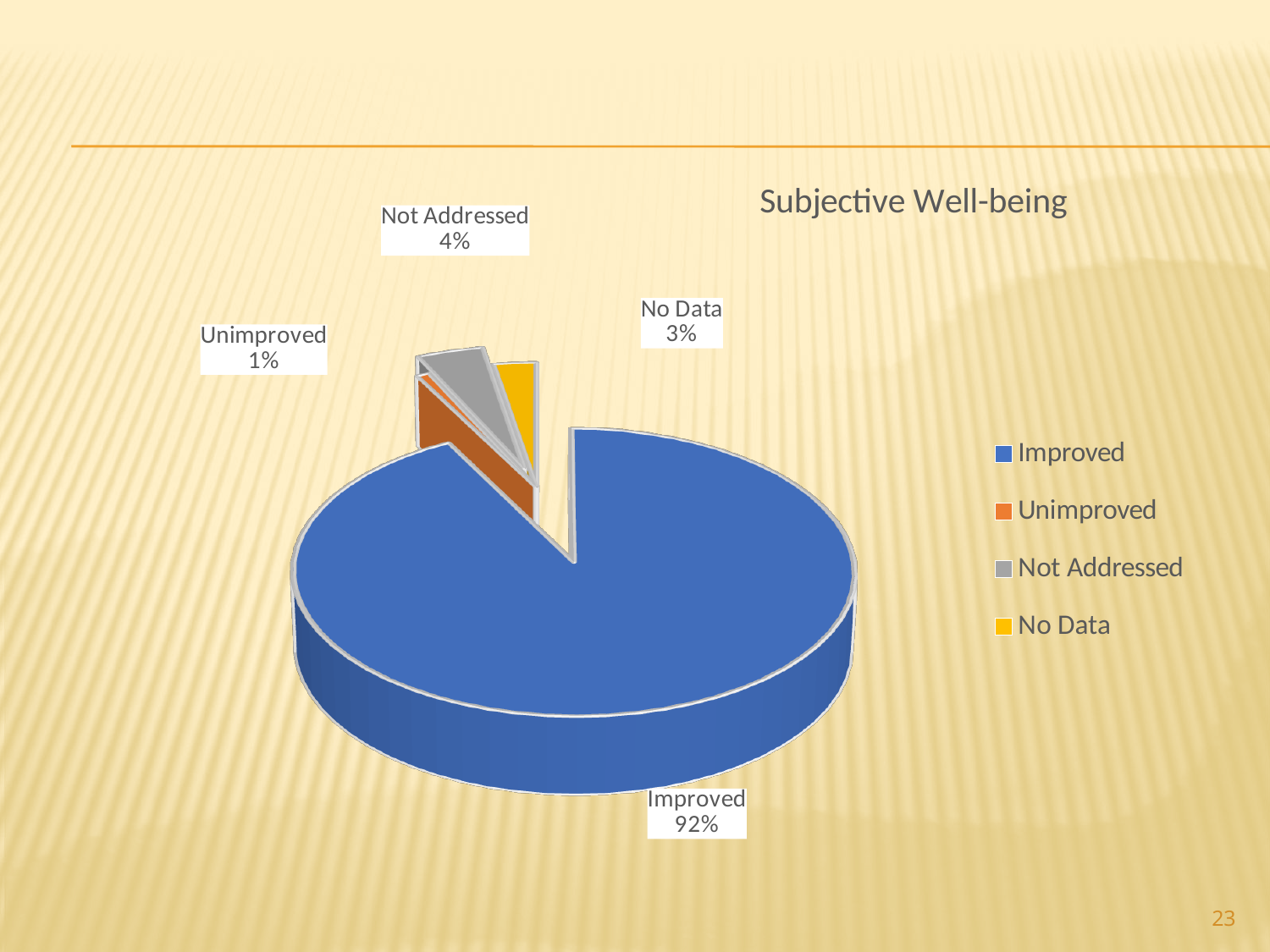
Which is larger, the share for Not Addressed or the share for No Data? Not Addressed What percentage of the pie is labelled No Data? 3% What is the difference in percentage points between the Improved share and the Not Addressed share? 88 What type of chart is shown on the slide? Pie chart What colour is the Improved slice? Blue What percentage of the pie is labelled Unimproved? 1% What percentage of the pie is labelled Improved? 92% Which category has the largest share of the pie? Improved How many categories does the legend list? 4 Which category has the smallest share of the pie? Unimproved What percentage of the pie is labelled Not Addressed? 4% What is the title of the chart? Subjective Well-being